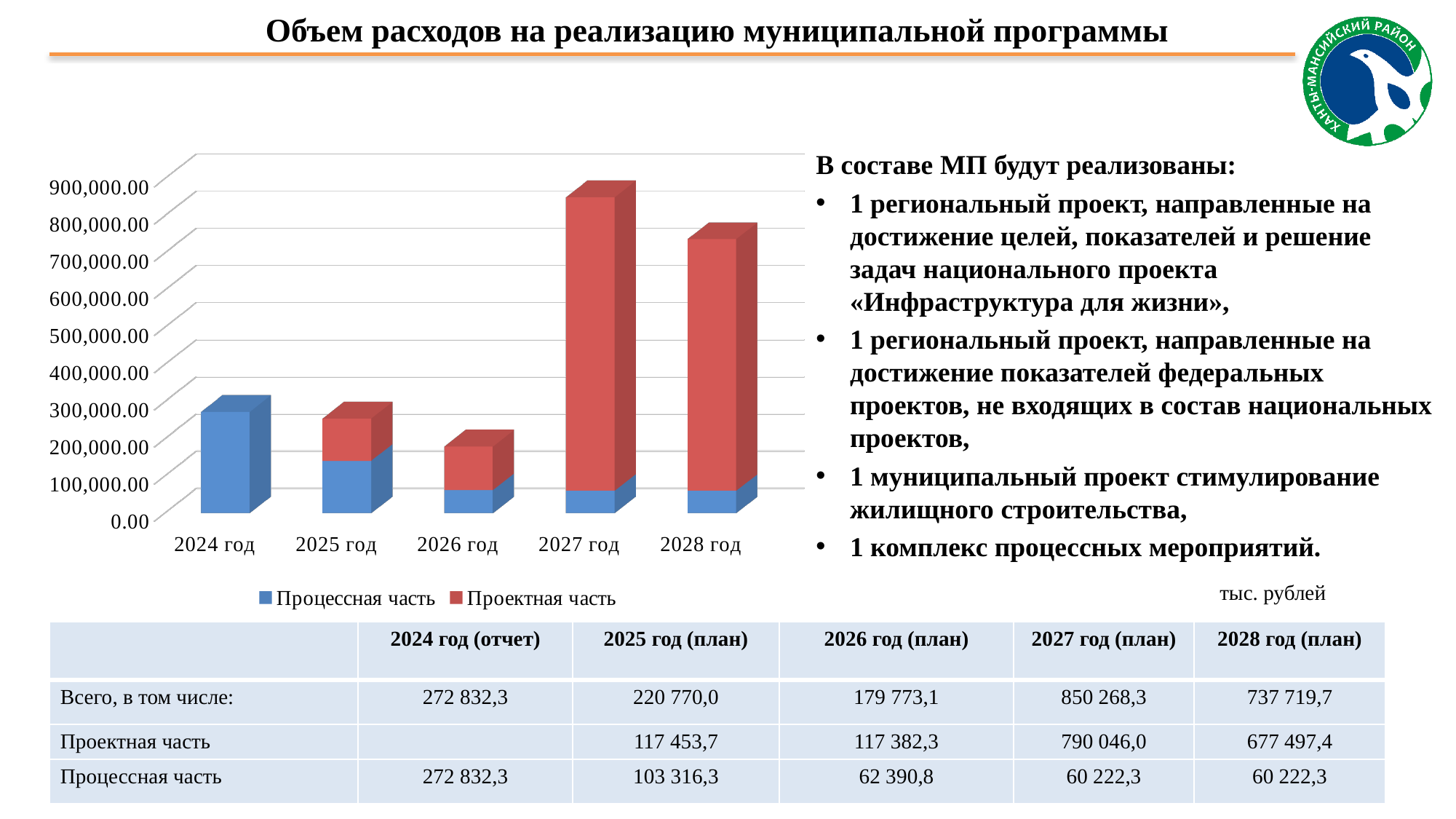
What is the total of the stacked bar for 2028 год? 737 719,7 What is the difference between the total for 2027 год and the total for 2028 год? 112 548,6 What is the value of Процессная часть for 2024 год? 272 832,3 How many year categories are plotted on the x axis of the chart? 5 What kind of chart is shown on the slide? Stacked bar chart Which year has the tallest stacked bar in the chart? 2027 год Which colour represents Проектная часть in the chart legend? Red Which year has the shortest stacked bar in the chart? 2026 год What is the value of Проектная часть for 2027 год? 790 046,0 Is the total value of the bar for 2027 год greater or less than 800,000.00? greater Is the value of the bar for 2024 год greater or less than 300,000.00? less How many series does the chart legend list? 2